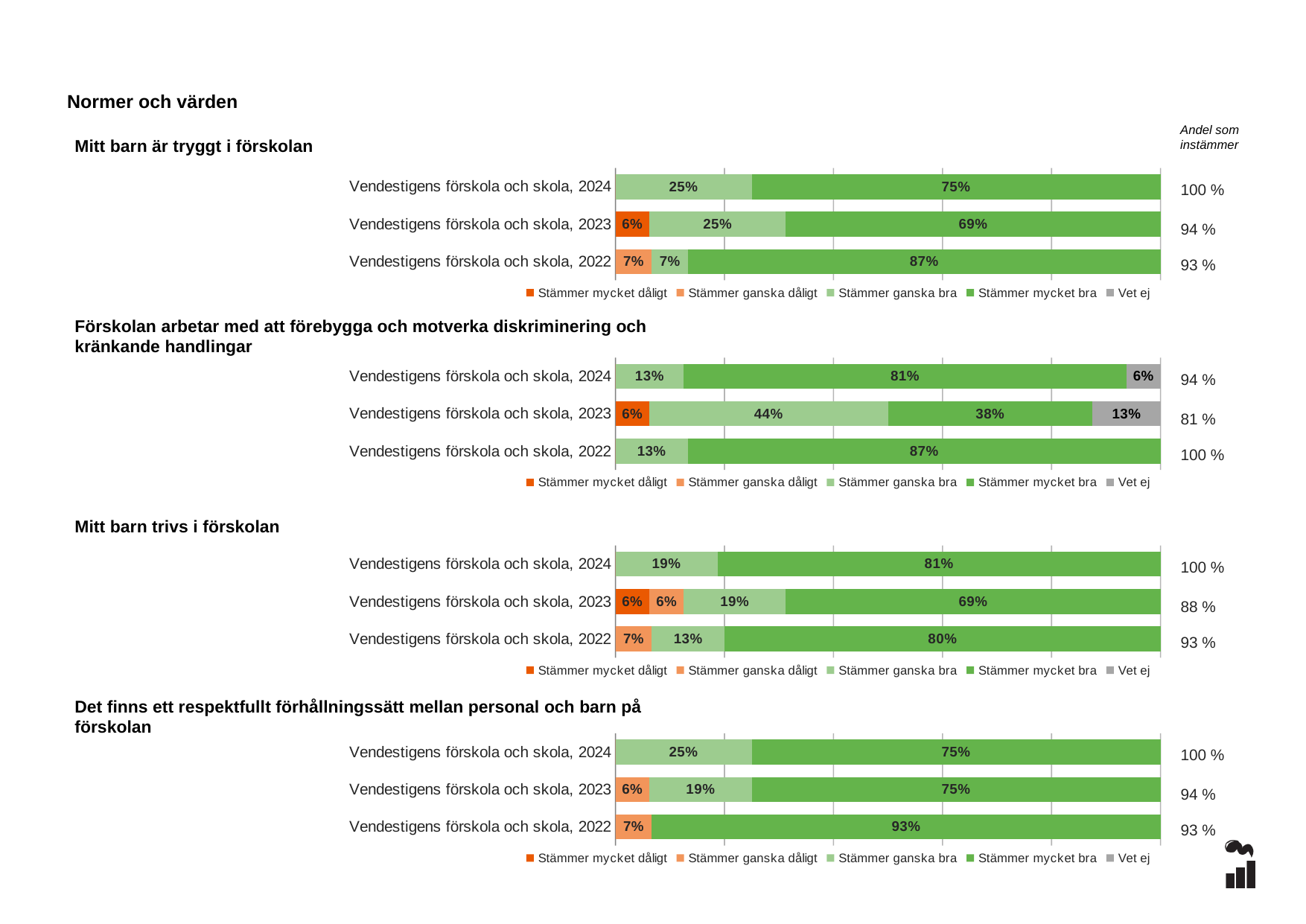
In the chart 'Mitt barn är tryggt i förskolan', what is the 'Stämmer mycket bra' value for Vendestigens förskola och skola, 2022? 87% In the chart 'Förskolan arbetar med att förebygga och motverka diskriminering och kränkande handlingar', what is the 'Vet ej' value for Vendestigens förskola och skola, 2023? 13% In the chart 'Förskolan arbetar med att förebygga och motverka diskriminering och kränkande handlingar', which year has the lowest 'Andel som instämmer'? 2023 In the chart 'Förskolan arbetar med att förebygga och motverka diskriminering och kränkande handlingar', what is the difference between the 'Stämmer ganska bra' values for 2023 and 2024? 31 percentage points In the chart 'Mitt barn trivs i förskolan', which year has the highest 'Stämmer mycket bra' value? 2024 What kind of chart is used for 'Mitt barn trivs i förskolan'? Stacked bar chart In the chart 'Det finns ett respektfullt förhållningssätt mellan personal och barn på förskolan', is the 'Stämmer mycket bra' value for 2023 larger or smaller than for 2022? smaller In the chart 'Mitt barn trivs i förskolan', what is the 'Andel som instämmer' for Vendestigens förskola och skola, 2023? 88 % In the chart 'Mitt barn trivs i förskolan', what is the 'Stämmer mycket bra' value for Vendestigens förskola och skola, 2023? 69% How many series does the legend list for the chart 'Mitt barn är tryggt i förskolan'? 5 In the chart 'Det finns ett respektfullt förhållningssätt mellan personal och barn på förskolan', what is the 'Stämmer mycket bra' value for Vendestigens förskola och skola, 2022? 93% In the chart 'Mitt barn är tryggt i förskolan', what is the 'Andel som instämmer' for Vendestigens förskola och skola, 2023? 94 %